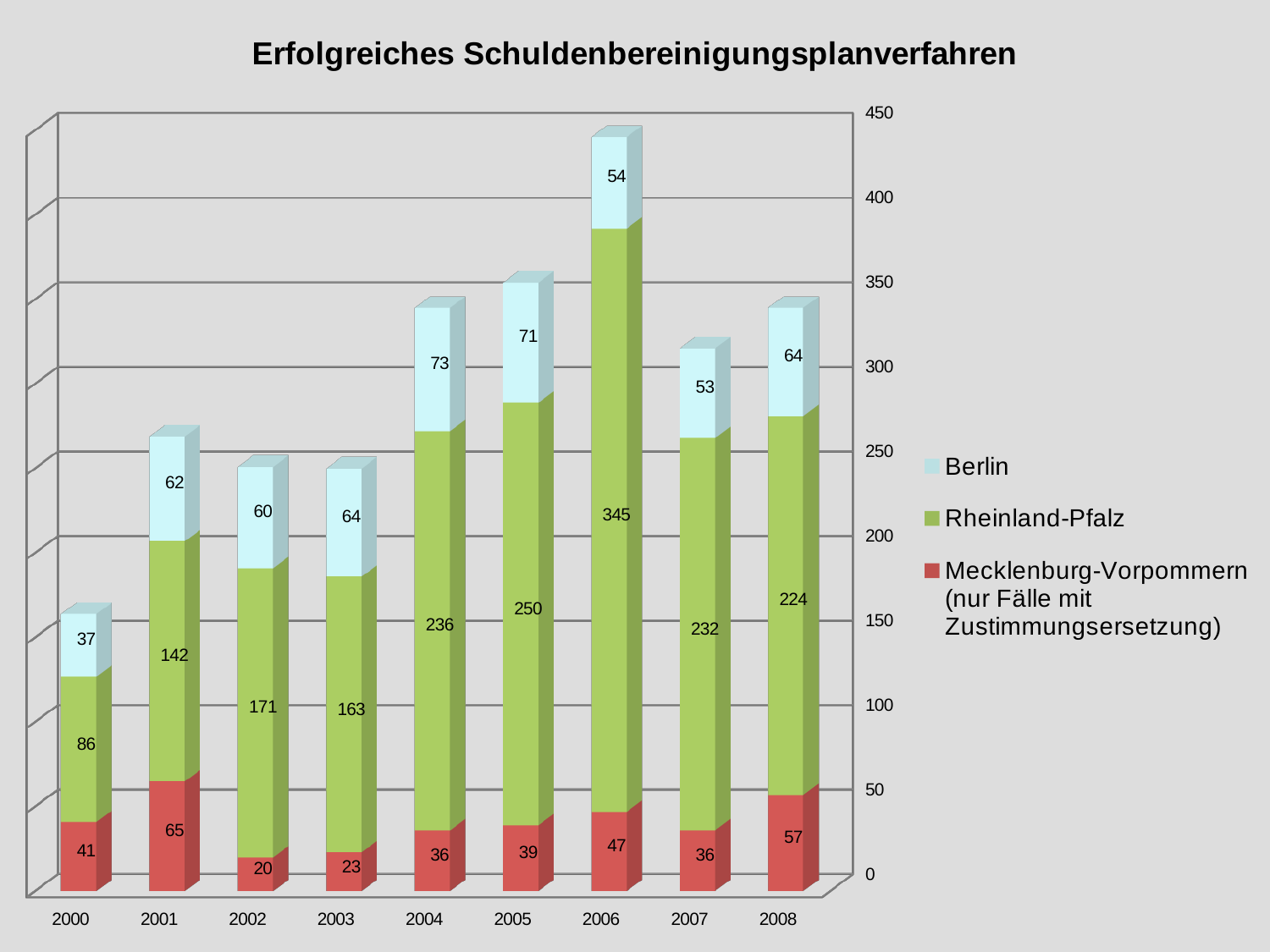
What is the value for Berlin in 2004? 73 What is the total of the stacked bar for 2006? 446 Which is larger, the Berlin value for 2001 or for 2007? 2001 What is the value for Rheinland-Pfalz in 2006? 345 What is the difference between the Rheinland-Pfalz values for 2005 and 2004? 14 How many series does the legend list? 3 In which year is the Rheinland-Pfalz value highest? 2006 What is the value for Mecklenburg-Vorpommern in 2001? 65 What kind of chart is shown on the slide? Stacked bar chart In which year is the Mecklenburg-Vorpommern value lowest? 2002 What is the total of the stacked bar for 2000? 164 How many years are shown on the x axis? 9